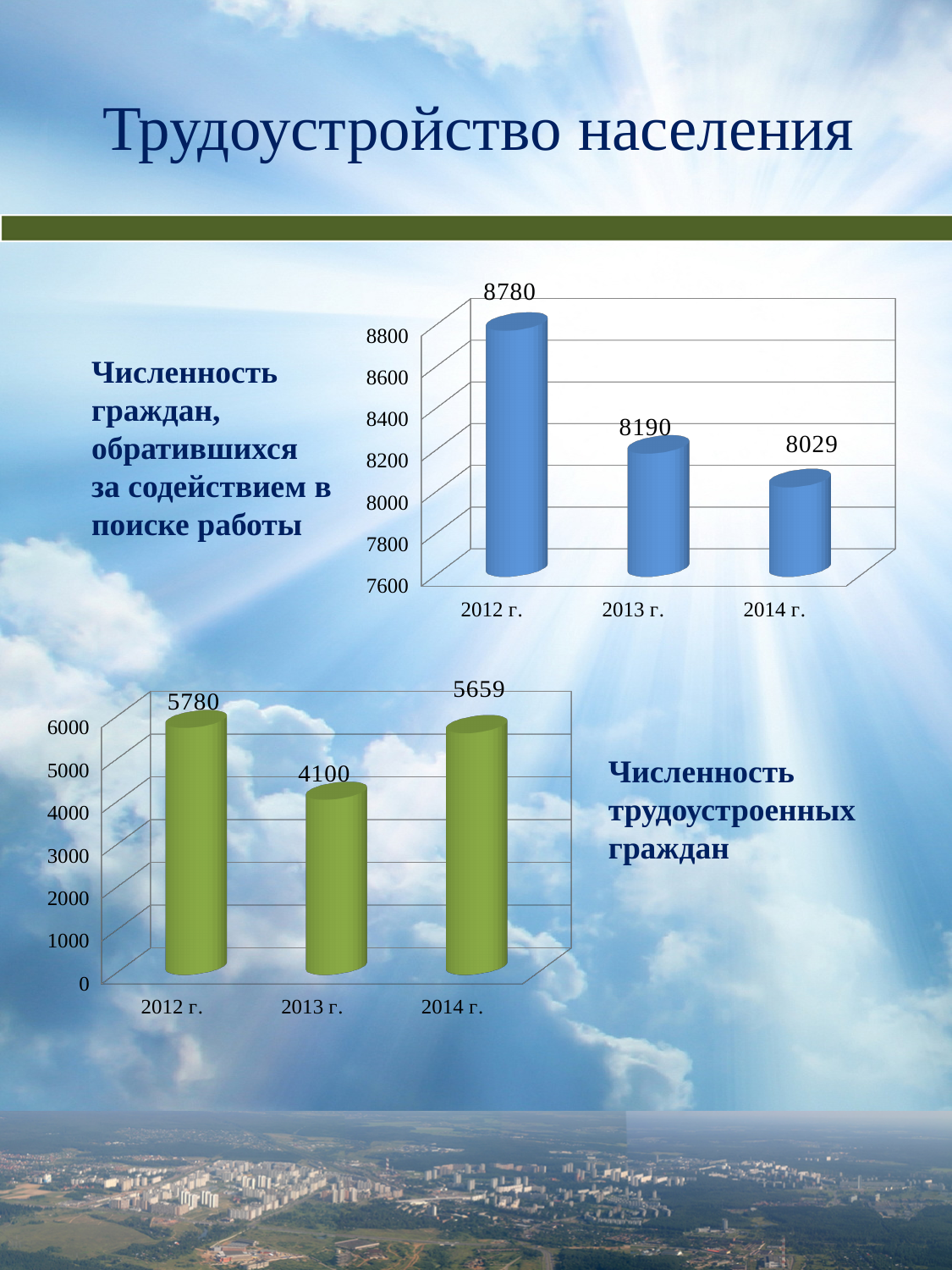
In the bottom chart (Численность трудоустроенных граждан), which year has the highest value? 2012 г. In the top chart (Численность граждан, обратившихся за содействием в поиске работы), what is the difference between the values for 2012 г. and 2013 г.? 590 In the bottom chart (Численность трудоустроенных граждан), which is larger: the value for 2012 г. or 2014 г.? 2012 г. In the bottom chart (Численность трудоустроенных граждан), what is the difference between the values for 2012 г. and 2013 г.? 1680 In the top chart (Численность граждан, обратившихся за содействием в поиске работы), what is the value for 2014 г.? 8029 In the top chart (Численность граждан, обратившихся за содействием в поиске работы), do the values rise or fall from 2012 г. to 2014 г.? fall In the bottom chart (Численность трудоустроенных граждан), what is the value for 2013 г.? 4100 In the top chart (Численность граждан, обратившихся за содействием в поиске работы), which year has the lowest value? 2014 г. In the top chart (Численность граждан, обратившихся за содействием в поиске работы), what is the value for 2012 г.? 8780 In the bottom chart (Численность трудоустроенных граждан), what is the value for 2014 г.? 5659 How many years are shown on the x axis of the bottom chart (Численность трудоустроенных граждан)? 3 What kind of chart is the top chart (Численность граждан, обратившихся за содействием в поиске работы)? bar chart